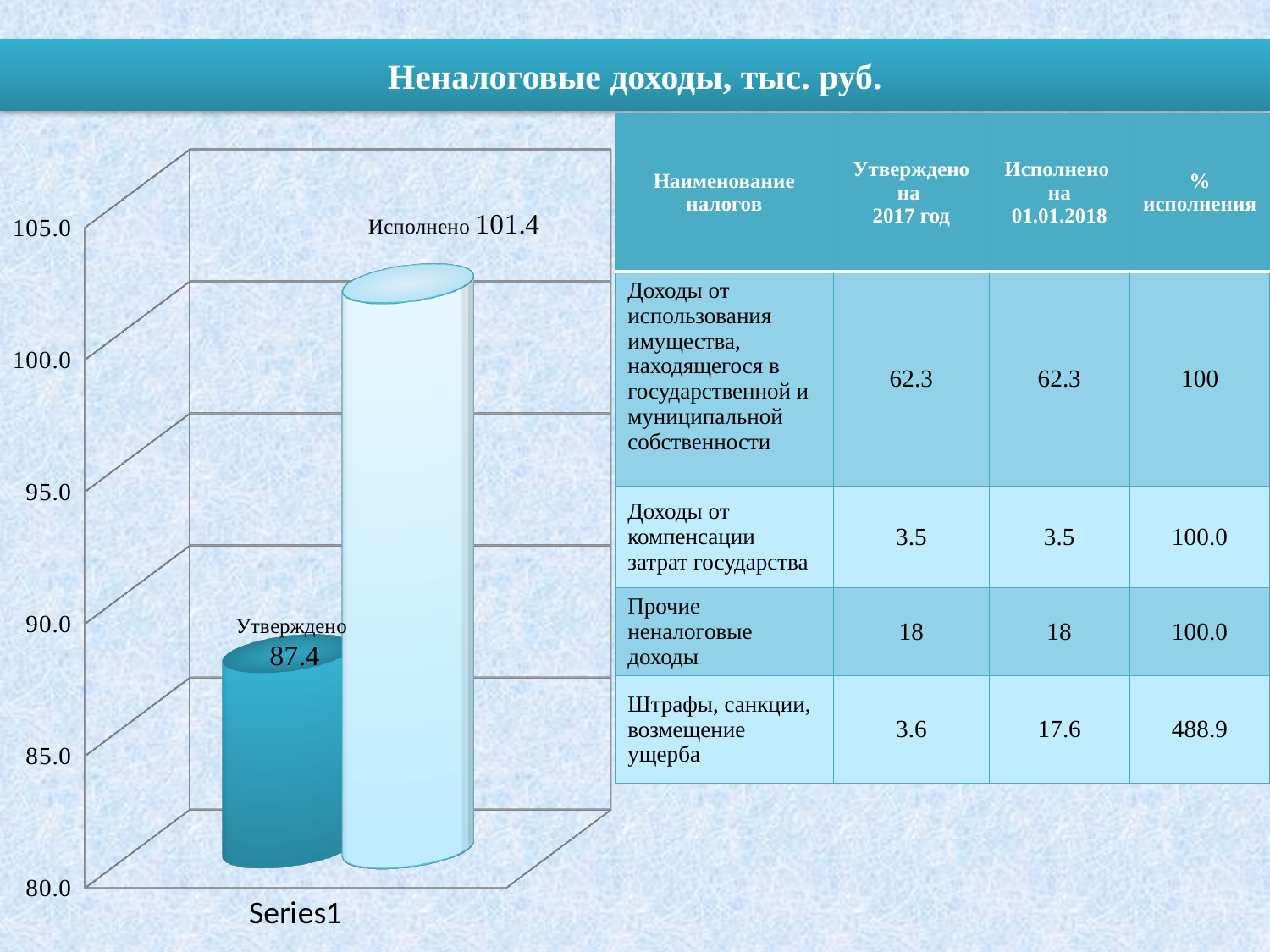
Which bar on the chart has the lowest value? Утверждено Is the value of the "Исполнено" bar greater or less than 100.0? greater Is the value of the "Утверждено" bar greater or less than 90.0? less What kind of chart is shown on the slide? Bar chart What is the difference between the "Исполнено" and "Утверждено" values on the chart? 14.0 What is the value of the "Утверждено" bar on the chart? 87.4 Which bar on the chart has the highest value? Исполнено What is the value of the "Исполнено" bar on the chart? 101.4 Which bar on the chart is taller, "Утверждено" or "Исполнено"? Исполнено What is the lowest value shown on the chart's vertical axis? 80.0 What is the label shown on the horizontal axis of the chart? Series1 How many bars are plotted on the chart? 2